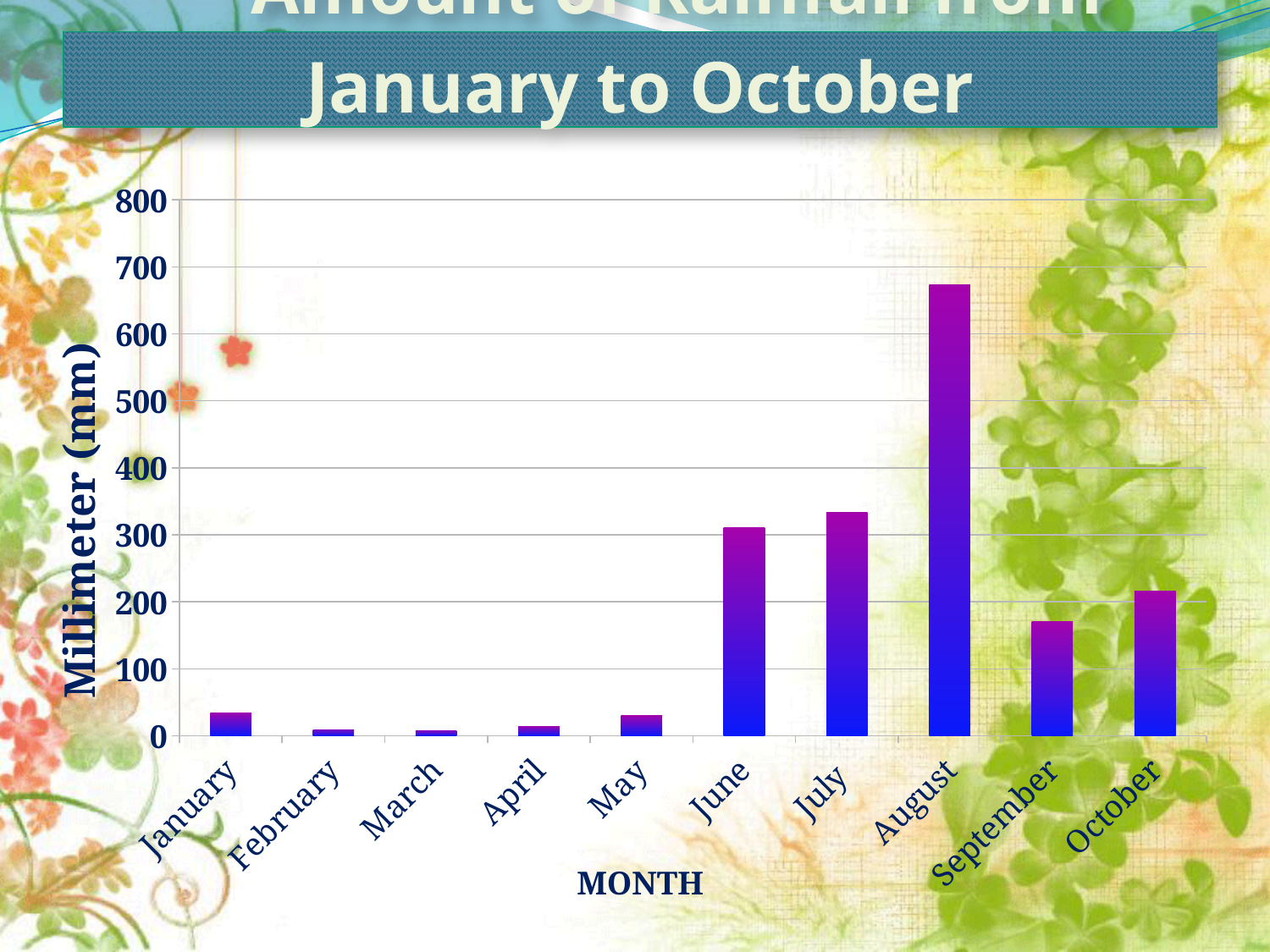
Is the value for September greater or less than 100? greater Is the value for September greater or less than 200? less Which is larger, the value for October or the value for September? October Is the value for July greater or less than 300? greater What is the title of the vertical axis? Millimeter (mm) What kind of chart is shown on the slide? bar chart Which is larger, the value for August or the value for July? August Which month has the highest rainfall? August Which is larger, the value for June or the value for May? June How many months are plotted on the x axis? 10